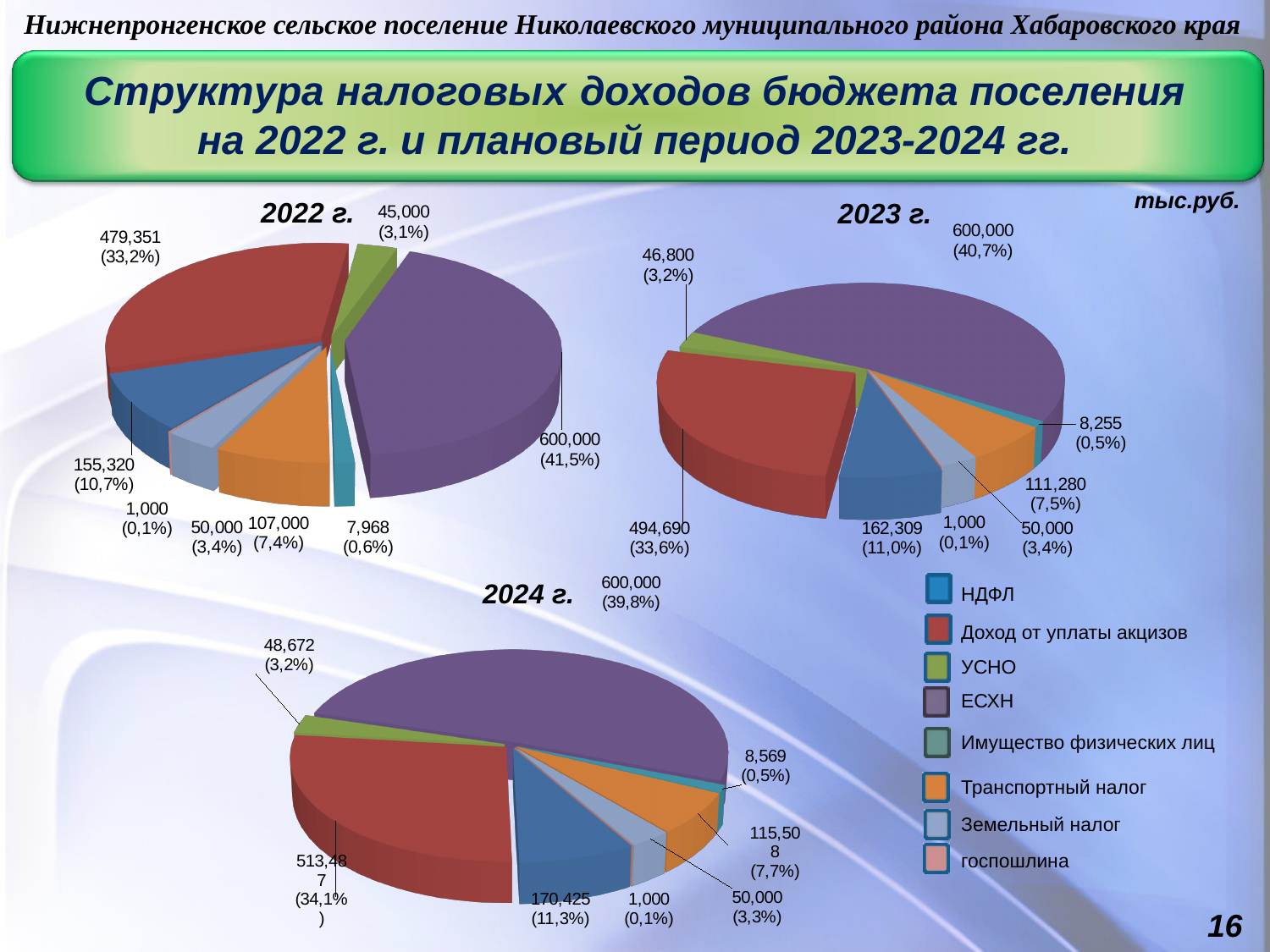
In the 2023 г. pie chart, which is larger: УСНО or Земельный налог? Земельный налог In the 2023 г. pie chart, what is the value for НДФЛ? 162,309 (11,0%) What unit is indicated for the values on the slide? тыс.руб. In the 2022 г. pie chart, what is the value for Имущество физических лиц? 7,968 (0,6%) In the 2023 г. pie chart, which category has the largest share? ЕСХН In the 2022 г. pie chart, what is the value for ЕСХН? 600,000 (41,5%) In the 2024 г. pie chart, which category has the smallest share? госпошлина What type of charts are shown on the slide? Pie charts In the 2024 г. pie chart, what is the difference between the values for ЕСХН and Доход от уплаты акцизов? 86,513 In the 2022 г. pie chart, what share does Доход от уплаты акцизов have? 33,2% How many series does the legend list? 8 In the 2024 г. pie chart, what is the value for Транспортный налог? 115,508 (7,7%)